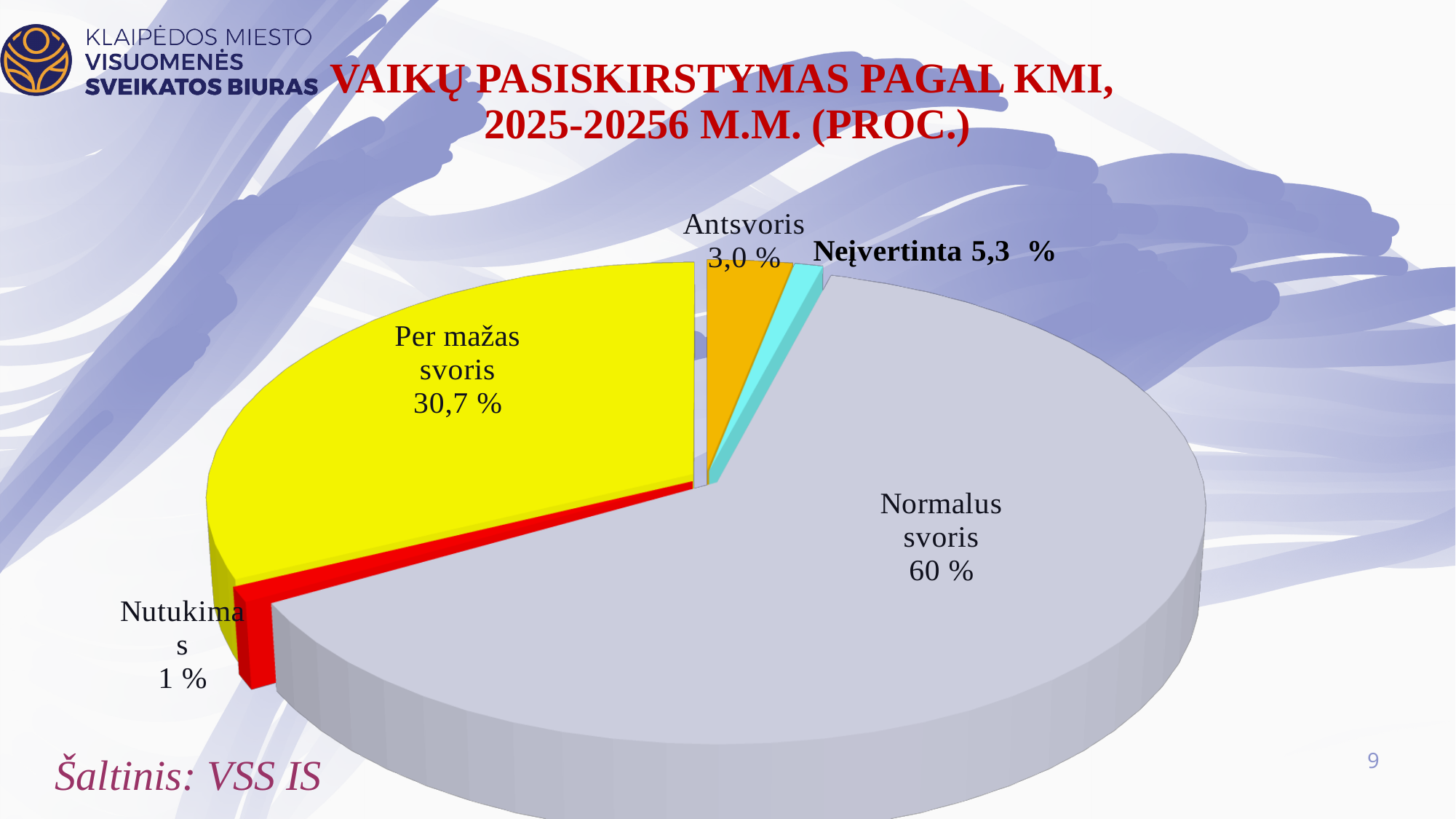
What colour is the 'Per mažas svoris' slice? Yellow Which category has the largest share of the pie? Normalus svoris What percentage of children are in the 'Normalus svoris' category? 60 % Which is larger, the share for 'Neįvertinta' or the share for 'Antsvoris'? Neįvertinta Which category has the smallest share of the pie? Nutukimas What type of chart is shown on the slide? Pie chart How many categories are shown in the pie chart? 5 What is the value shown for 'Per mažas svoris'? 30,7 % What is the value for 'Neįvertinta'? 5,3 % What percentage is labelled 'Antsvoris'? 3,0 % What percentage is shown for 'Nutukimas'? 1 % What is the difference between the 'Normalus svoris' and 'Per mažas svoris' shares? 29,3 %